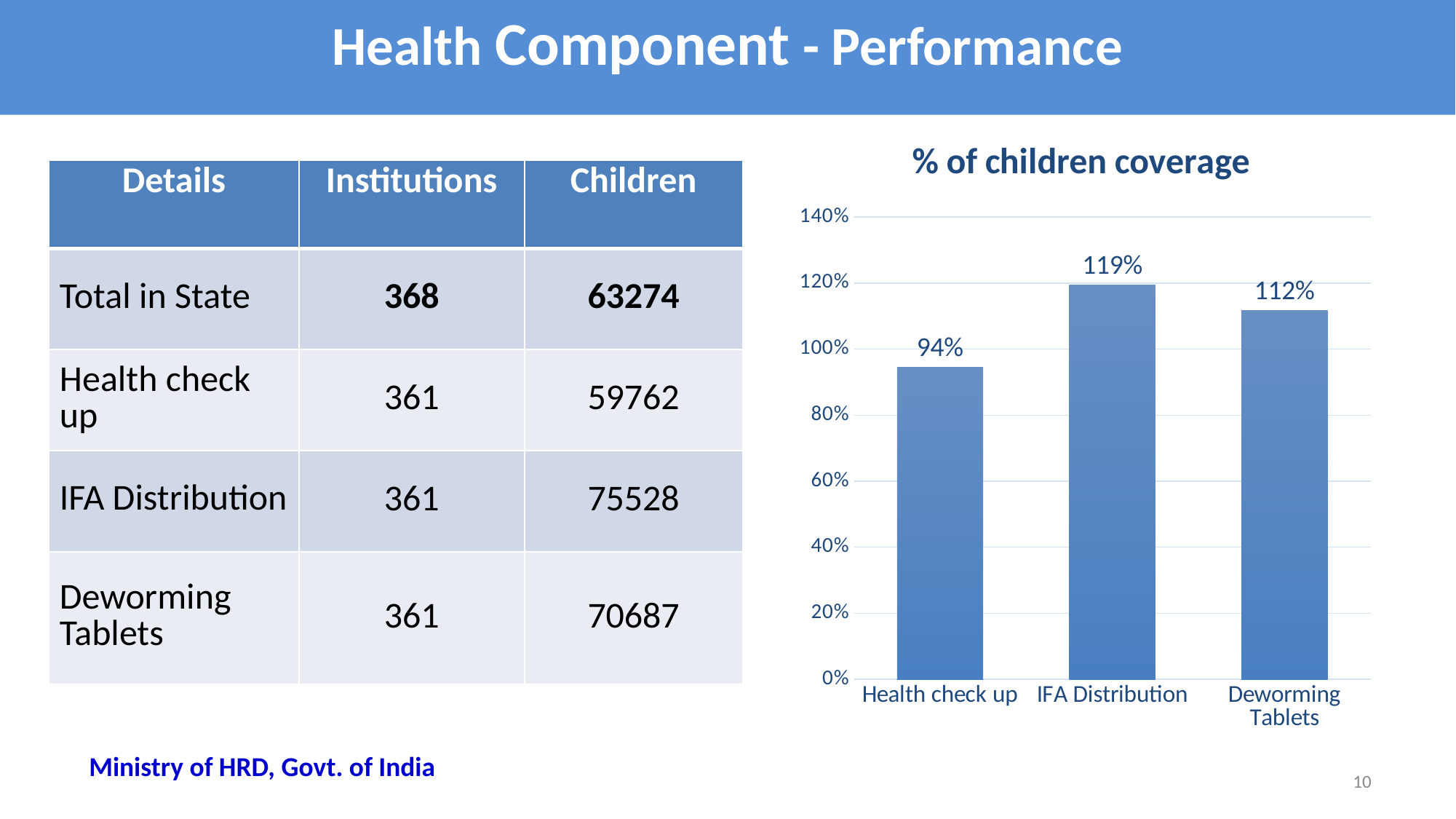
How many categories are shown in the chart? 3 Is the value for Health check up greater or less than 100%? less What is the value for Deworming Tablets in the chart? 112% What is the value for IFA Distribution in the chart? 119% Which category has the highest % of children coverage? IFA Distribution Which is larger, the value for Deworming Tablets or the value for Health check up? Deworming Tablets What is the value for Health check up in the chart? 94% What is the title of the chart? % of children coverage What kind of chart is shown on the slide? bar chart Which category has the lowest % of children coverage? Health check up What is the difference between the values for IFA Distribution and Health check up? 25% What is the difference between the values for IFA Distribution and Deworming Tablets? 7%